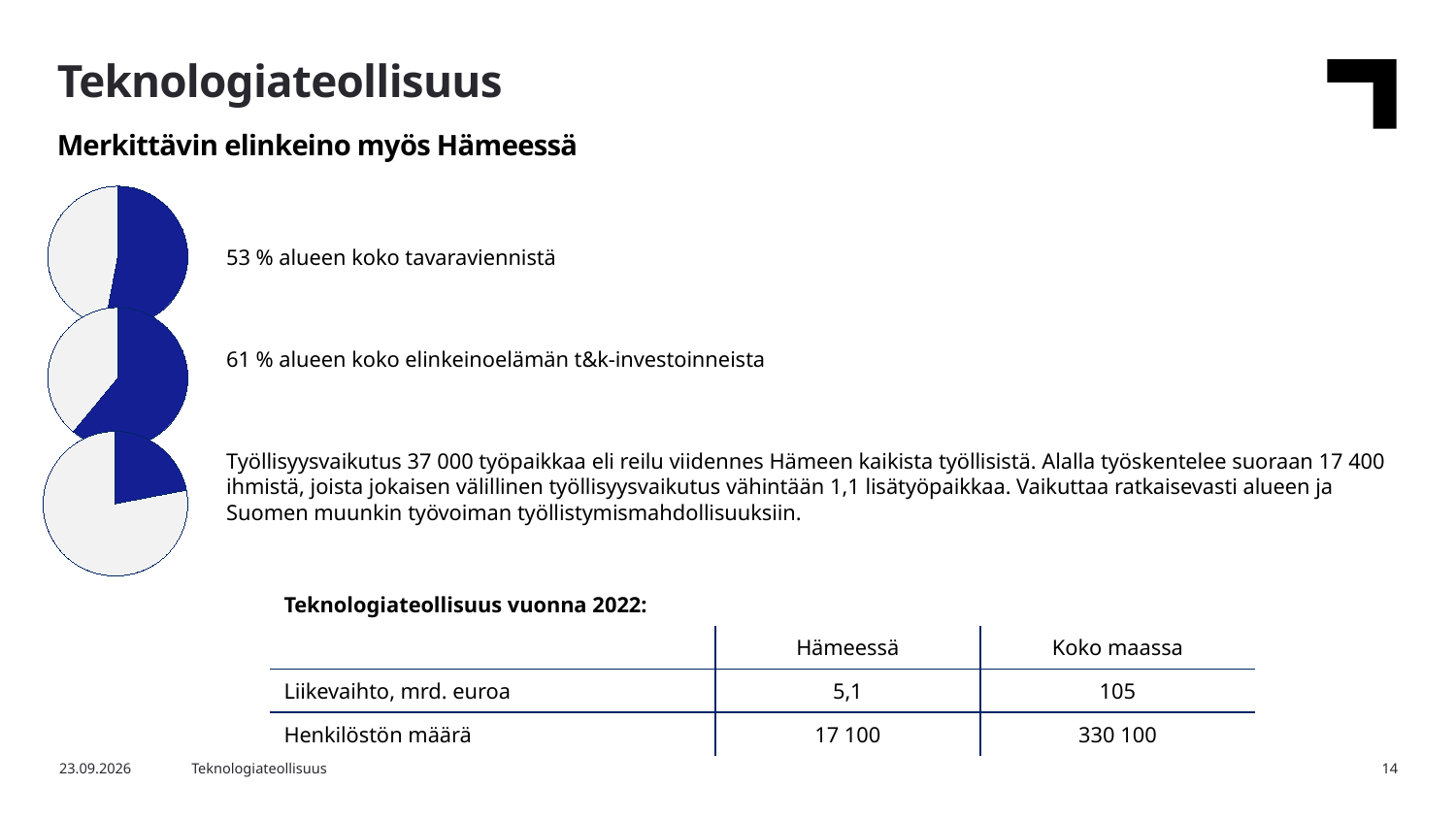
Which of the three pie charts has the largest blue slice? the middle one In the middle pie chart, what share does the blue slice represent according to the text beside it? 61 % According to the text next to the top pie chart, what does its blue slice represent? alueen koko tavaraviennistä Which of the three pie charts has the smallest blue slice? the bottom one In the top pie chart, what share does the blue slice represent according to the text beside it? 53 % What colour is the highlighted slice in each pie chart? blue In the bottom pie chart, is the blue slice greater or less than 50% of the pie? less What kind of chart is the top chart on the left of the slide? pie chart In the middle pie chart, is the blue slice greater or less than 50% of the pie? greater Which pie chart has the larger blue slice, the top one or the bottom one? the top one How many pie charts are shown on the slide? 3 Which pie chart has the larger blue slice, the top one or the middle one? the middle one